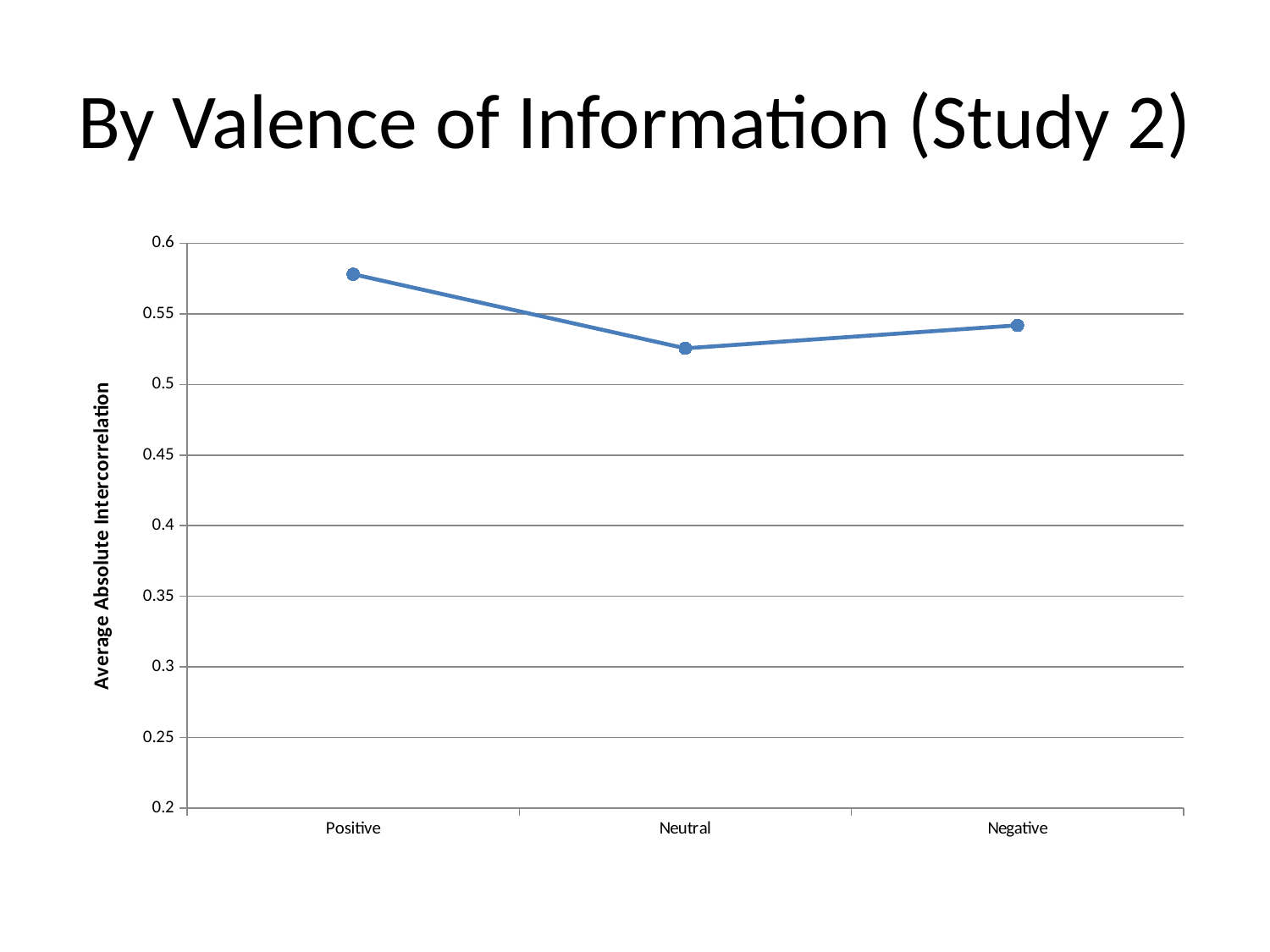
Is the value for Neutral greater or less than 0.55? less Which is larger, the value for Positive or the value for Negative? Positive How many categories are plotted on the x axis? 3 Which category has the highest average absolute intercorrelation? Positive Does the line rise or fall from Positive to Neutral? fall What is the title of the slide? By Valence of Information (Study 2) What kind of chart is shown on the slide? line chart Which is larger, the value for Positive or the value for Neutral? Positive Is the value for Neutral greater or less than 0.5? greater What is the title of the y axis? Average Absolute Intercorrelation Is the value for Positive greater or less than 0.55? greater Which category has the lowest average absolute intercorrelation? Neutral